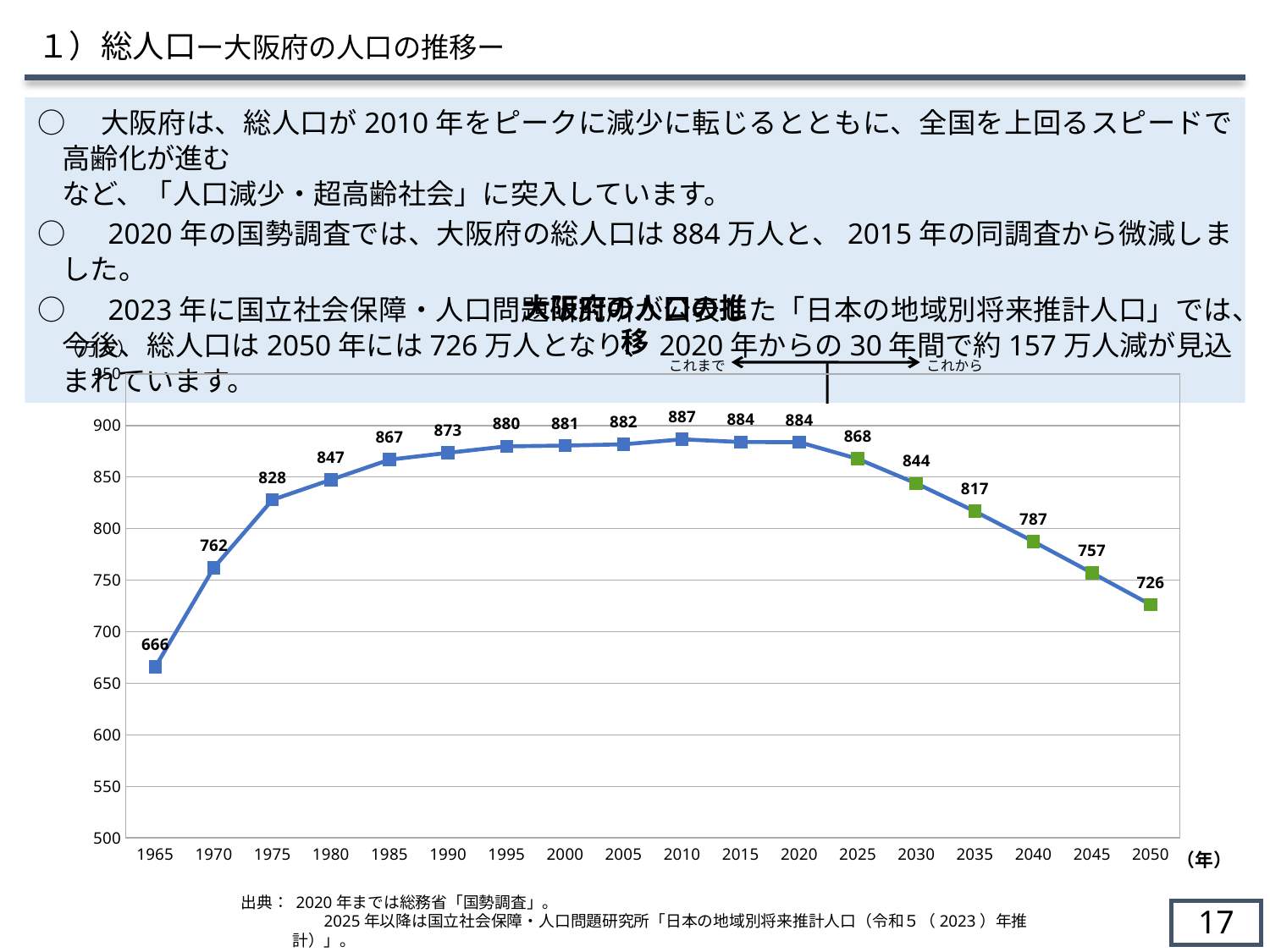
What is the value plotted for 2010? 887 What is the value plotted for 1965? 666 Which is larger, the value for 1985 or the value for 2035? 1985 What is the value plotted for 2030? 844 Which year has the highest plotted value? 2010 What kind of chart is shown on the slide? Line chart Which year has the lowest plotted value? 1965 What is the difference between the values for 1965 and 1970? 96 Do the plotted values rise or fall from 2020 to 2050? Fall What is the value plotted for 2050? 726 What is the difference between the values for 2020 and 2050? 158 How many data points are plotted on the chart? 18